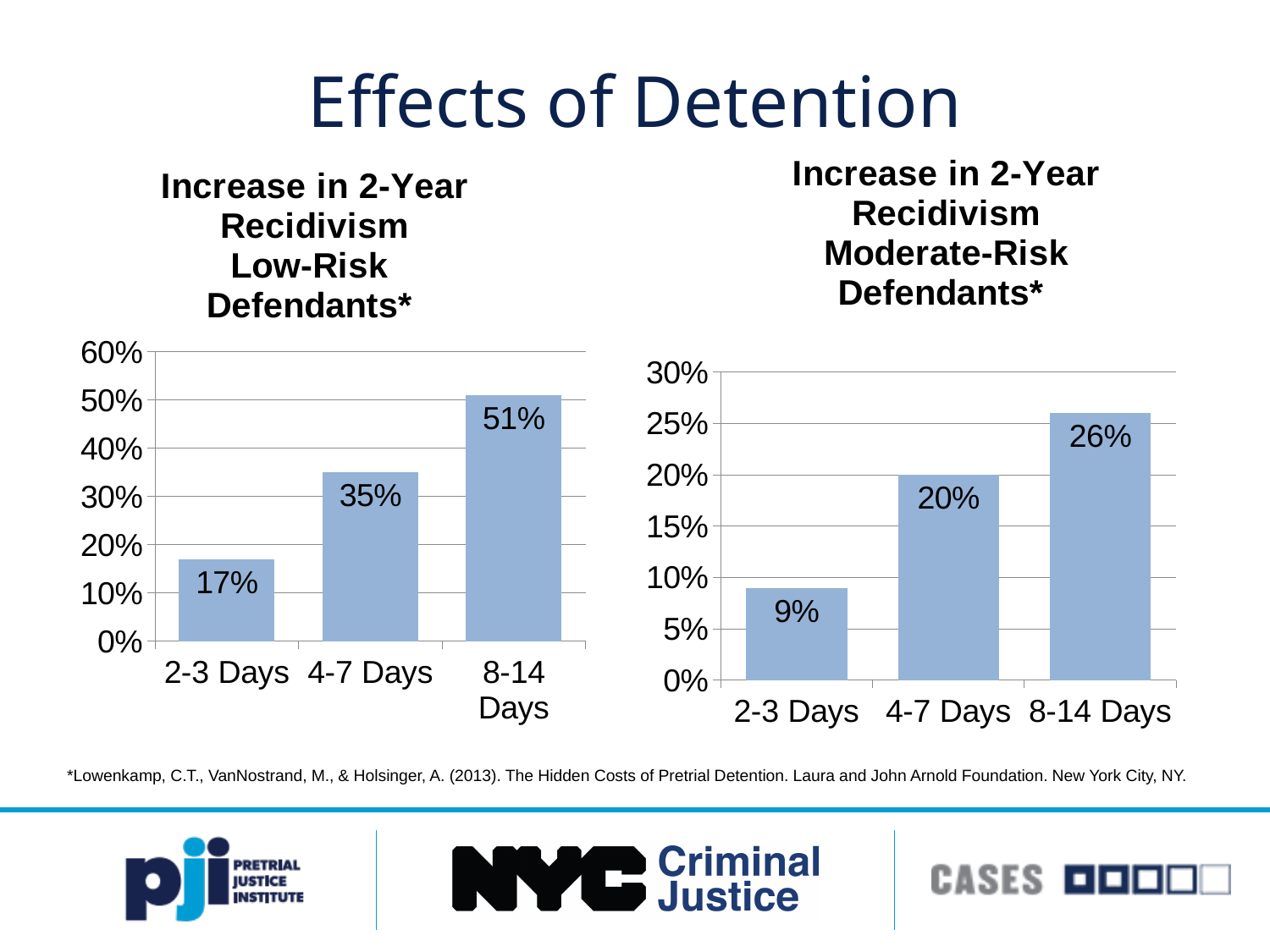
In the Low-Risk Defendants chart, what is the increase in 2-year recidivism for 4-7 Days? 35% In the Moderate-Risk Defendants chart, which detention length has the lowest value? 2-3 Days What is the maximum value shown on the y-axis of the Moderate-Risk Defendants chart? 30% Which is larger: the 8-14 Days value in the Low-Risk Defendants chart or the 8-14 Days value in the Moderate-Risk Defendants chart? Low-Risk Defendants In the Low-Risk Defendants chart, which detention length has the highest value? 8-14 Days In the Moderate-Risk Defendants chart, what is the value for 2-3 Days? 9% In the Moderate-Risk Defendants chart, do the values rise or fall as detention length increases? Rise In the Low-Risk Defendants chart, is the value for 4-7 Days greater or less than 30%? greater How many detention-length categories are shown in the Moderate-Risk Defendants chart? 3 In the Moderate-Risk Defendants chart, what is the difference between the values for 8-14 Days and 4-7 Days? 6% What type of chart is the Low-Risk Defendants chart? Bar chart In the Low-Risk Defendants chart, what is the difference between the values for 8-14 Days and 2-3 Days? 34%